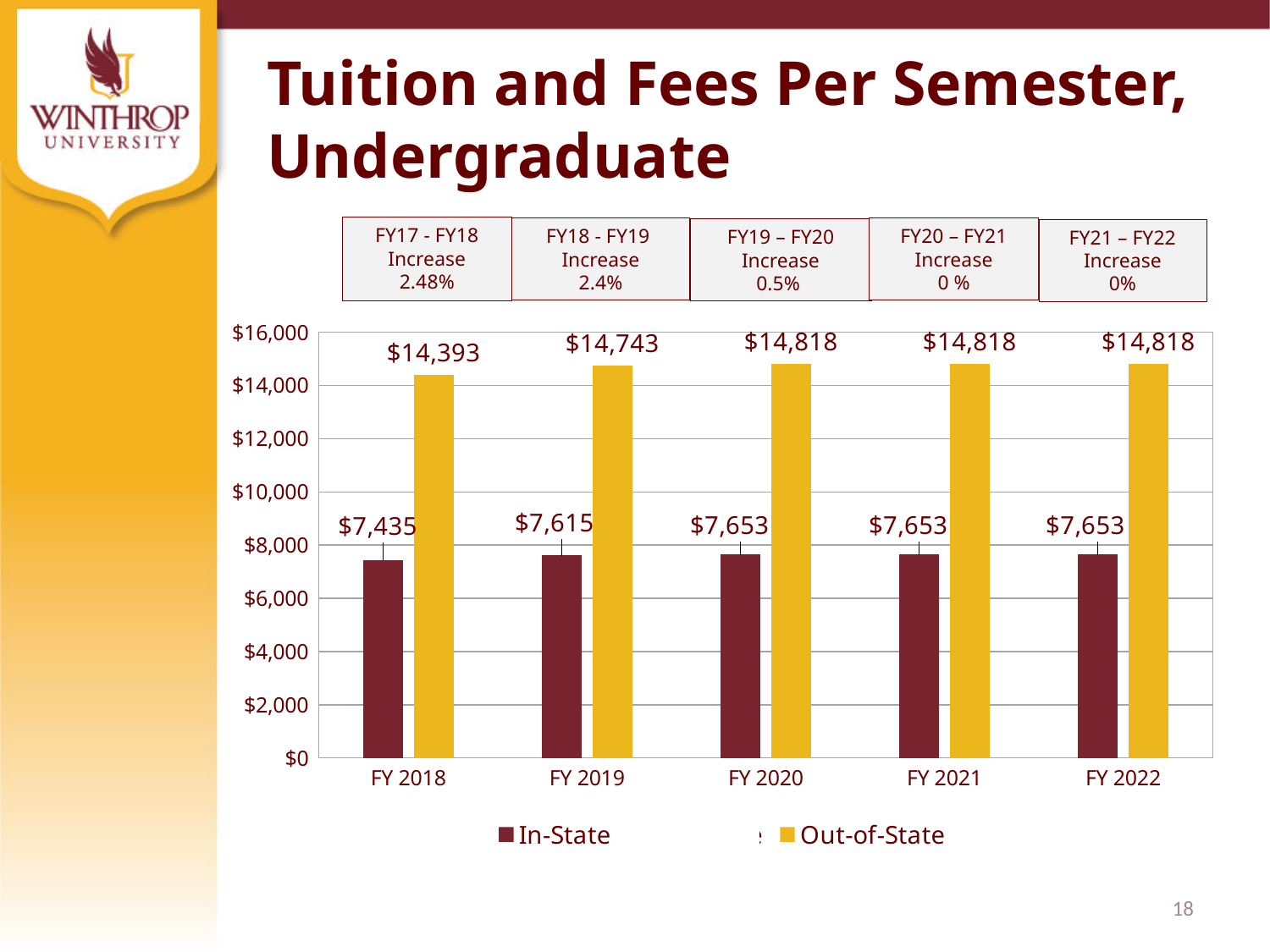
What is the Out-of-State tuition and fees per semester for FY 2019? $14,743 What kind of chart is shown on the slide? Bar chart What is the difference between the Out-of-State values for FY 2019 and FY 2018? $350 How many fiscal years are shown on the x axis? 5 How many series does the legend list? 2 What is the difference between the Out-of-State and In-State values for FY 2018? $6,958 What is the In-State value for FY 2020? $7,653 Which is larger, the In-State value for FY 2019 or the In-State value for FY 2018? FY 2019 What is the FY19 – FY20 increase shown above the chart? 0.5% Which fiscal year has the lowest In-State tuition and fees? FY 2018 What is the In-State tuition and fees per semester for FY 2018? $7,435 What is the Out-of-State value for FY 2022? $14,818